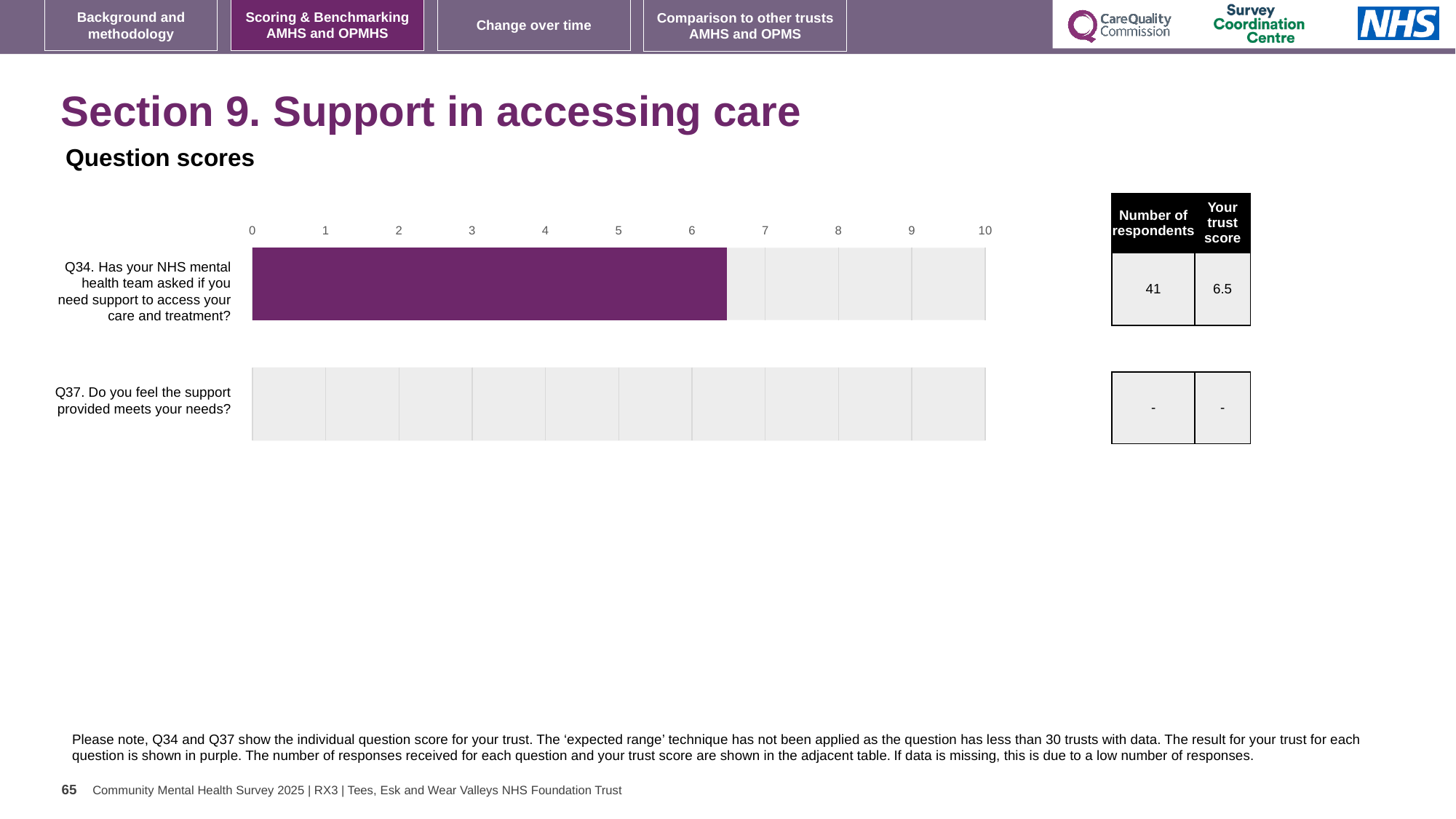
What is the trust score shown in the table for Q37? - What kind of chart is used to show the question scores? bar chart How many respondents answered Q34 according to the table? 41 Which question on the chart has no bar and shows '-' in the table? Q37 What is the maximum value shown on the chart's axis? 10 Is the value for Q34 greater or less than 7? less What is the trust score for Q34 shown in the table next to the chart? 6.5 How many questions are listed on the chart? 2 Is the value for Q34 greater or less than 6? greater What colour is the bar for Q34? purple